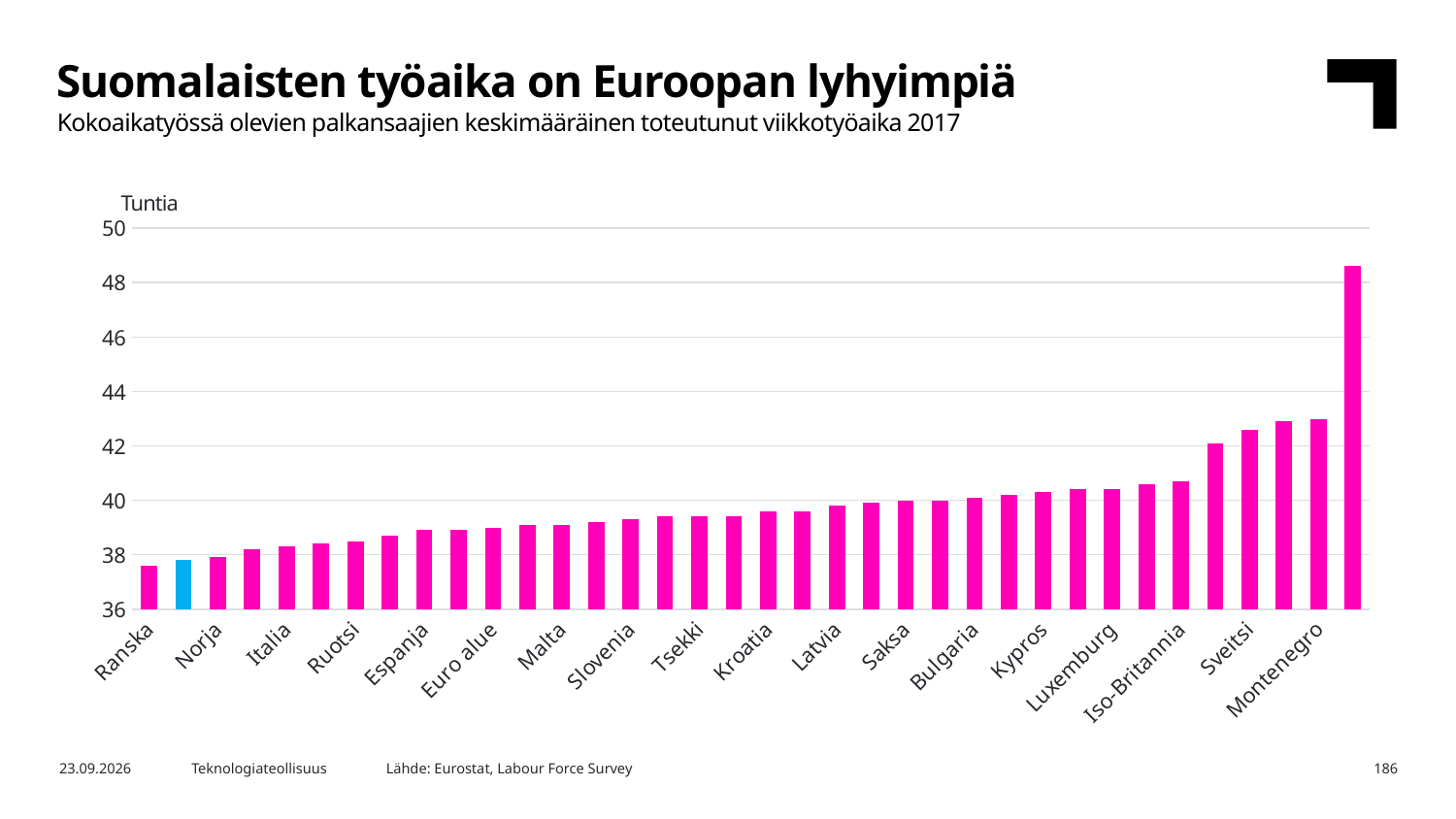
Is the value for Ranska greater or less than 38? less Is the value for Montenegro greater or less than 42? greater Do the values generally rise or fall from left to right along the x axis? Rise Is the value for Italia greater or less than 40? less What kind of chart is shown on the slide? Bar chart Which is larger, the value for Ruotsi or the value for Sveitsi? Sveitsi Which is larger, the value for Montenegro or the value for Ranska? Montenegro What unit is shown at the top of the vertical axis? Tuntia What is the title of the chart on the slide? Suomalaisten työaika on Euroopan lyhyimpiä